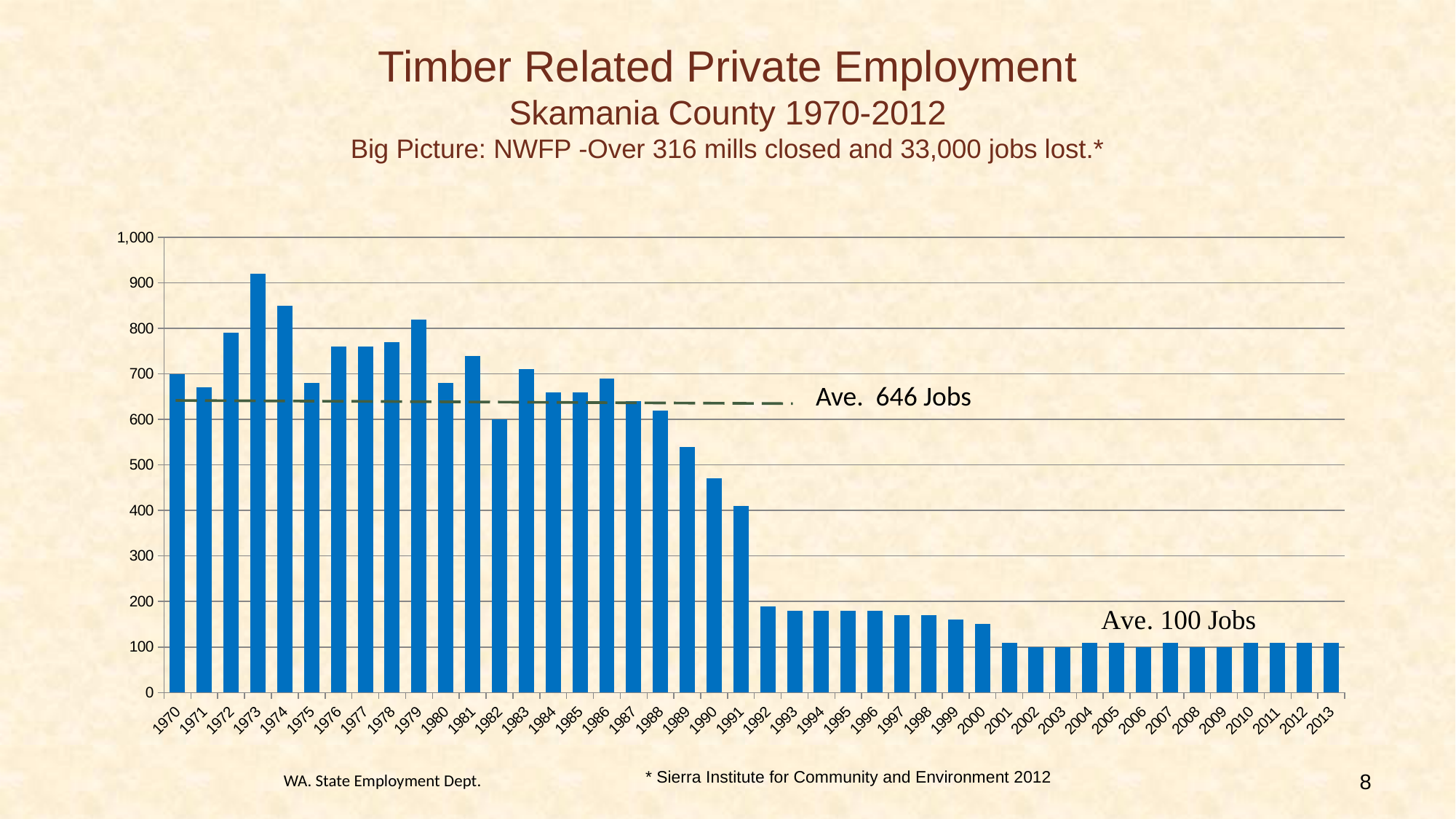
What average number of jobs does the dashed line annotation give for the earlier period? Ave. 646 Jobs What kind of chart is shown on the slide? bar chart Is the value for 1991 greater or less than 500? less Is the value for 1989 greater or less than 500? greater What average number of jobs is annotated for the later period (2001 onward)? Ave. 100 Jobs Is the value for 1974 greater or less than 800? greater Which year has the highest timber related private employment? 1973 Which year has the larger value, 1979 or 1980? 1979 How many years (bars) are plotted on the x axis? 44 Overall, do the values rise or fall from 1970 to 2013? fall